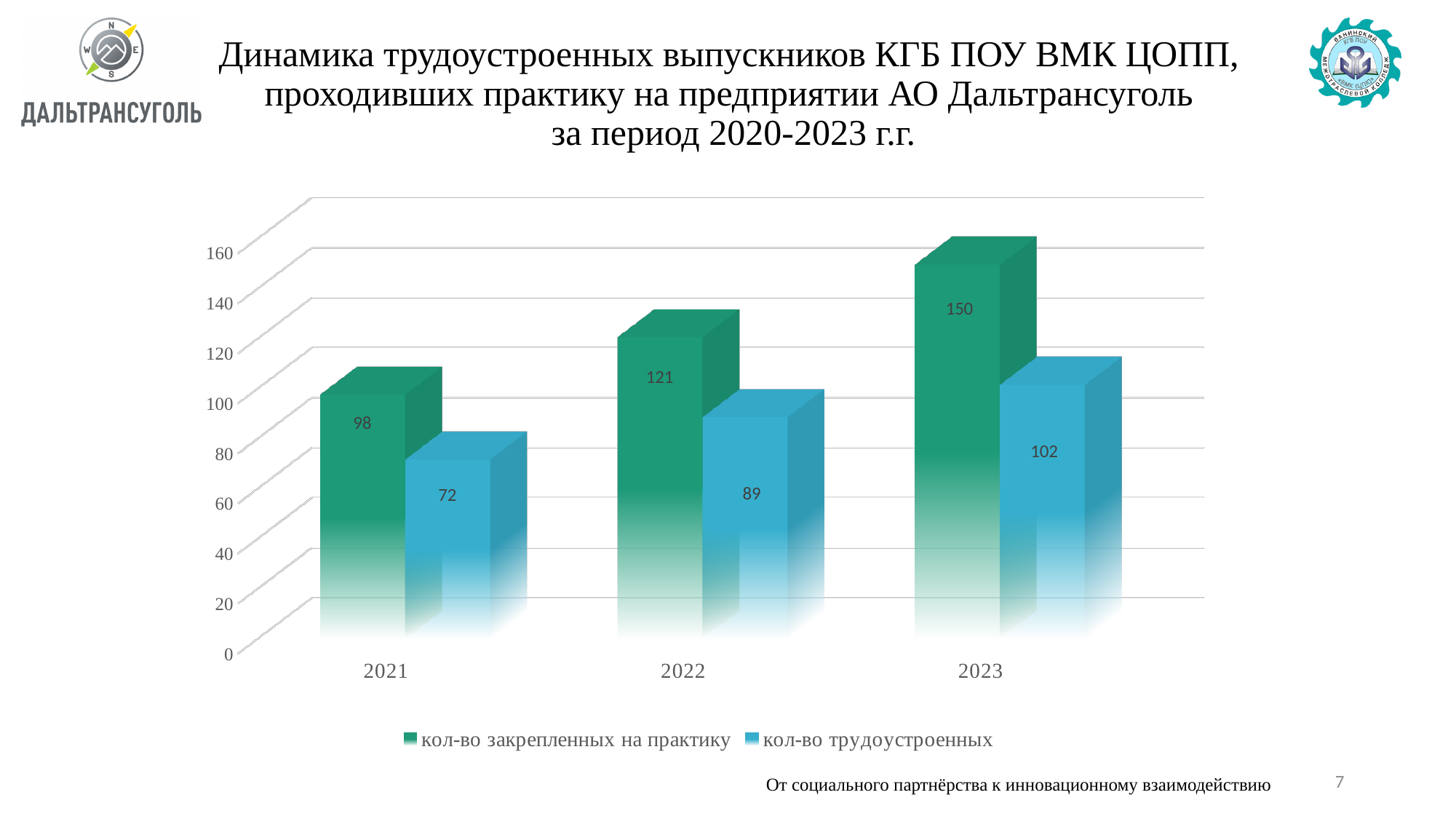
What colour are the bars for 'кол-во трудоустроенных'? blue Which year has the lowest value for 'кол-во трудоустроенных'? 2021 How many series does the legend list? 2 Which is larger: 'кол-во трудоустроенных' in 2022 or 'кол-во закрепленных на практику' in 2021? кол-во закрепленных на практику in 2021 Which year has the highest value for 'кол-во закрепленных на практику'? 2023 How many years are shown on the x axis? 3 What is the value of 'кол-во трудоустроенных' for 2021? 72 What kind of chart is shown on the slide? bar chart Do the values for 'кол-во трудоустроенных' rise or fall from 2021 to 2023? rise What is the difference between 'кол-во закрепленных на практику' and 'кол-во трудоустроенных' in 2023? 48 What is the value of 'кол-во закрепленных на практику' for 2022? 121 What is the value of 'кол-во трудоустроенных' for 2023? 102